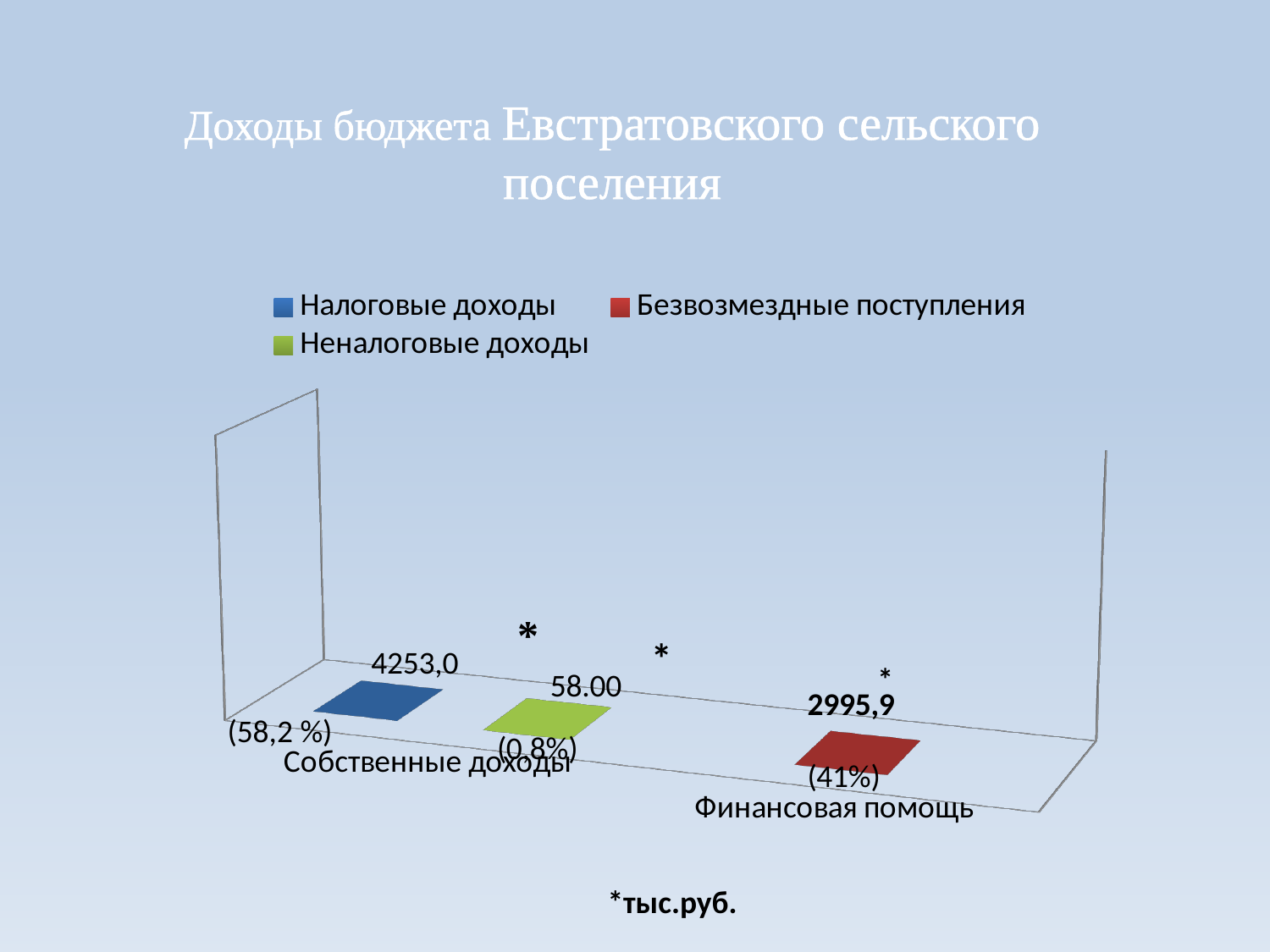
How many series does the legend list? 3 Which series has the lowest value? Неналоговые доходы What value is shown for Налоговые доходы? 4253,0 What unit is indicated for the values on the chart? тыс.руб. What percentage share is shown next to Безвозмездные поступления? 41% Which is larger, the value for Налоговые доходы or for Безвозмездные поступления? Налоговые доходы Which series has the highest value? Налоговые доходы What value is shown for Неналоговые доходы? 58.00 What percentage share is shown next to Налоговые доходы? 58,2 % What is the difference between the values for Налоговые доходы (4253,0) and Безвозмездные поступления (2995,9)? 1257,1 How many categories are shown on the x axis? 2 What value is shown for Безвозмездные поступления? 2995,9